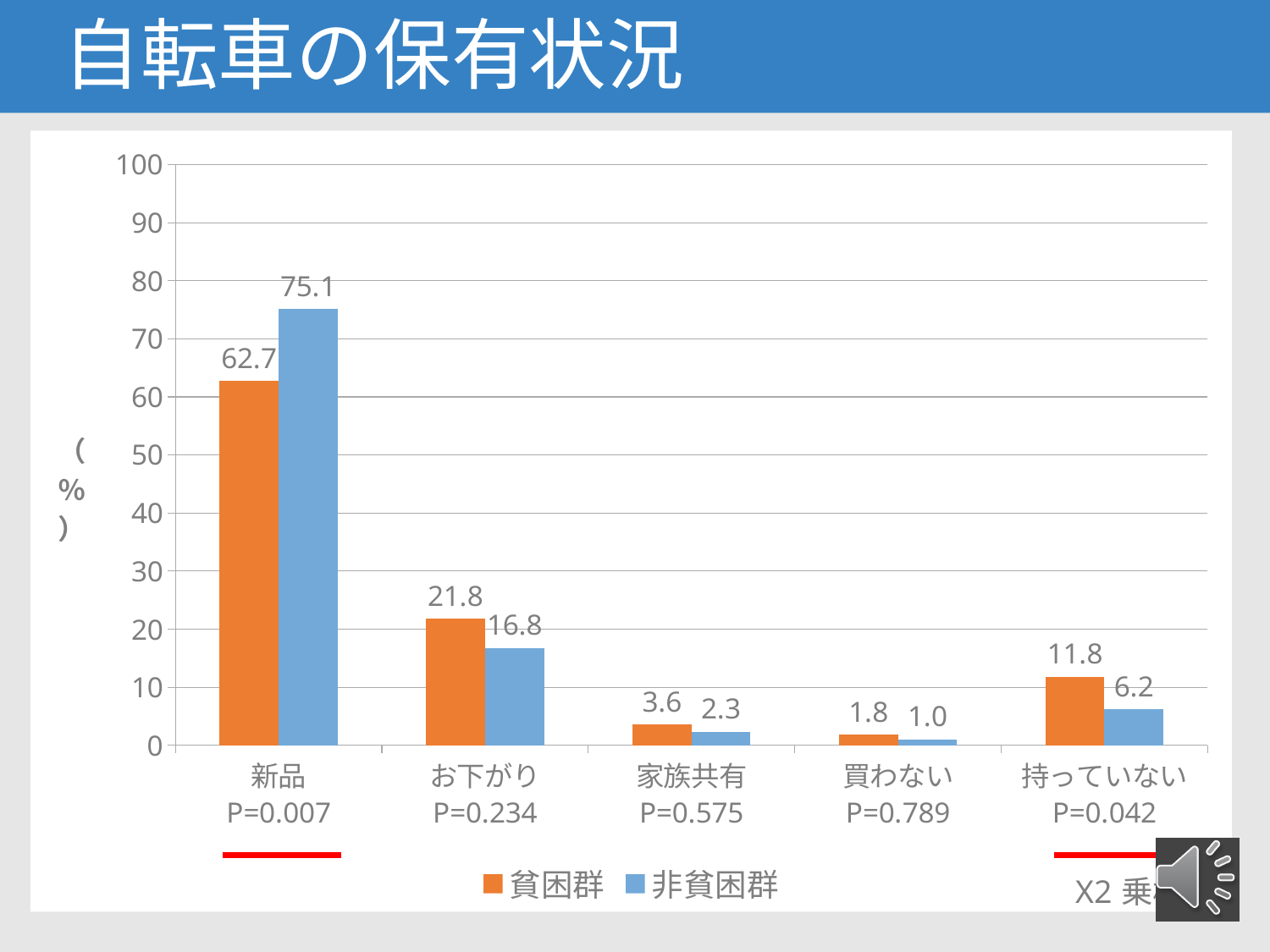
Which category has the lowest value for 貧困群? 買わない What is the difference between 非貧困群 and 貧困群 in the 新品 category? 12.4 What is the value for 非貧困群 in the 持っていない category? 6.2 What is the value for 貧困群 in the 新品 category? 62.7 What kind of chart is shown on the slide? bar chart Which is larger in the 持っていない category, 貧困群 or 非貧困群? 貧困群 Is the value for 貧困群 in the お下がり category greater or less than 20? greater What is the value for 非貧困群 in the お下がり category? 16.8 Which category has the highest value for 非貧困群? 新品 What is the P value shown under the 持っていない category? P=0.042 How many series does the legend list? 2 How many categories are shown on the x axis? 5